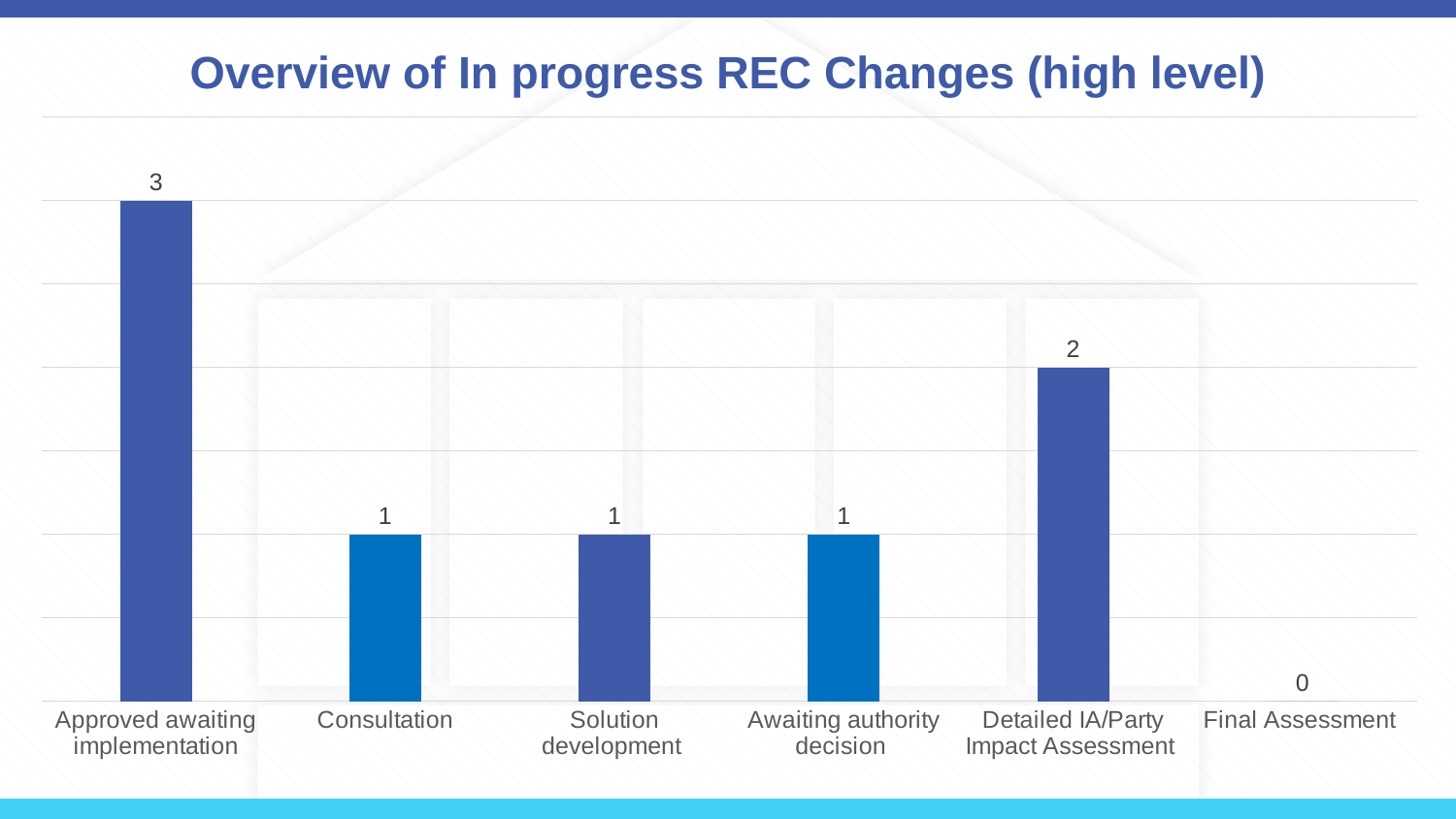
Which category has the lowest value? Final Assessment What is the value for Final Assessment? 0 What is the value for Approved awaiting implementation? 3 Which category has the highest value? Approved awaiting implementation What is the value for Detailed IA/Party Impact Assessment? 2 What kind of chart is shown on the slide? Bar chart What is the title of the slide? Overview of In progress REC Changes (high level) How many categories are shown on the x axis? 6 What is the value for Consultation? 1 What is the total of all the values shown in the chart? 8 What is the difference between the values for Approved awaiting implementation and Detailed IA/Party Impact Assessment? 1 Which is larger, the value for Detailed IA/Party Impact Assessment or the value for Solution development? Detailed IA/Party Impact Assessment